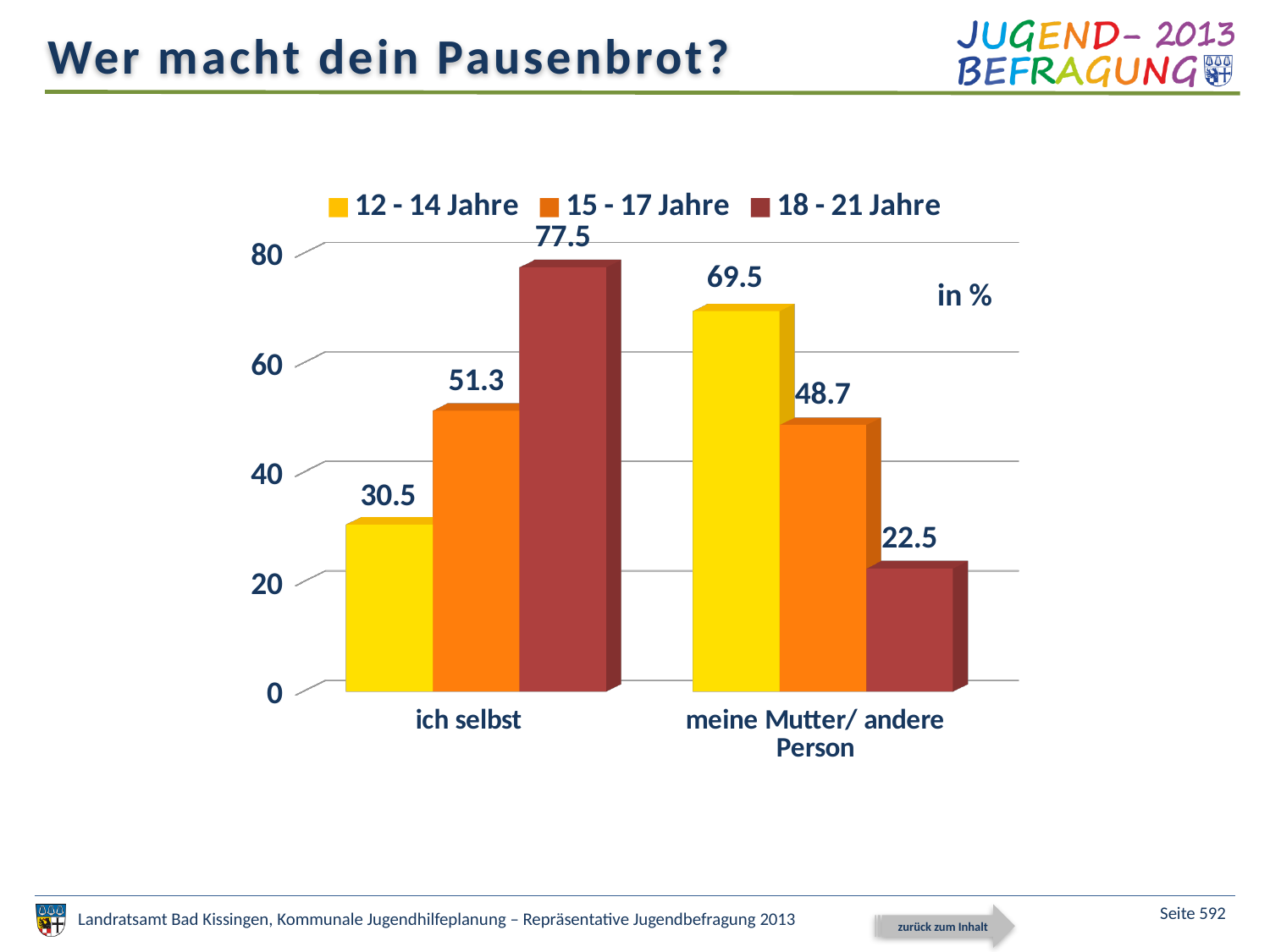
What is the difference between the 12 - 14 Jahre values for "meine Mutter/ andere Person" and "ich selbst"? 39 How many categories are shown on the x axis? 2 What is the value for the 15 - 17 Jahre series in the "ich selbst" category? 51.3 What is the value for the 18 - 21 Jahre series in the "ich selbst" category? 77.5 Is the value for 18 - 21 Jahre in the "meine Mutter/ andere Person" category greater or less than 40? less Which age group has the highest value in the "ich selbst" category? 18 - 21 Jahre Which age group has the lowest value in the "meine Mutter/ andere Person" category? 18 - 21 Jahre What is the title of the slide containing the chart? Wer macht dein Pausenbrot? What is the value for the 12 - 14 Jahre series in the "meine Mutter/ andere Person" category? 69.5 How many series does the legend list? 3 What kind of chart is shown on the slide? bar chart Which is larger: the 15 - 17 Jahre value for "ich selbst" or for "meine Mutter/ andere Person"? ich selbst